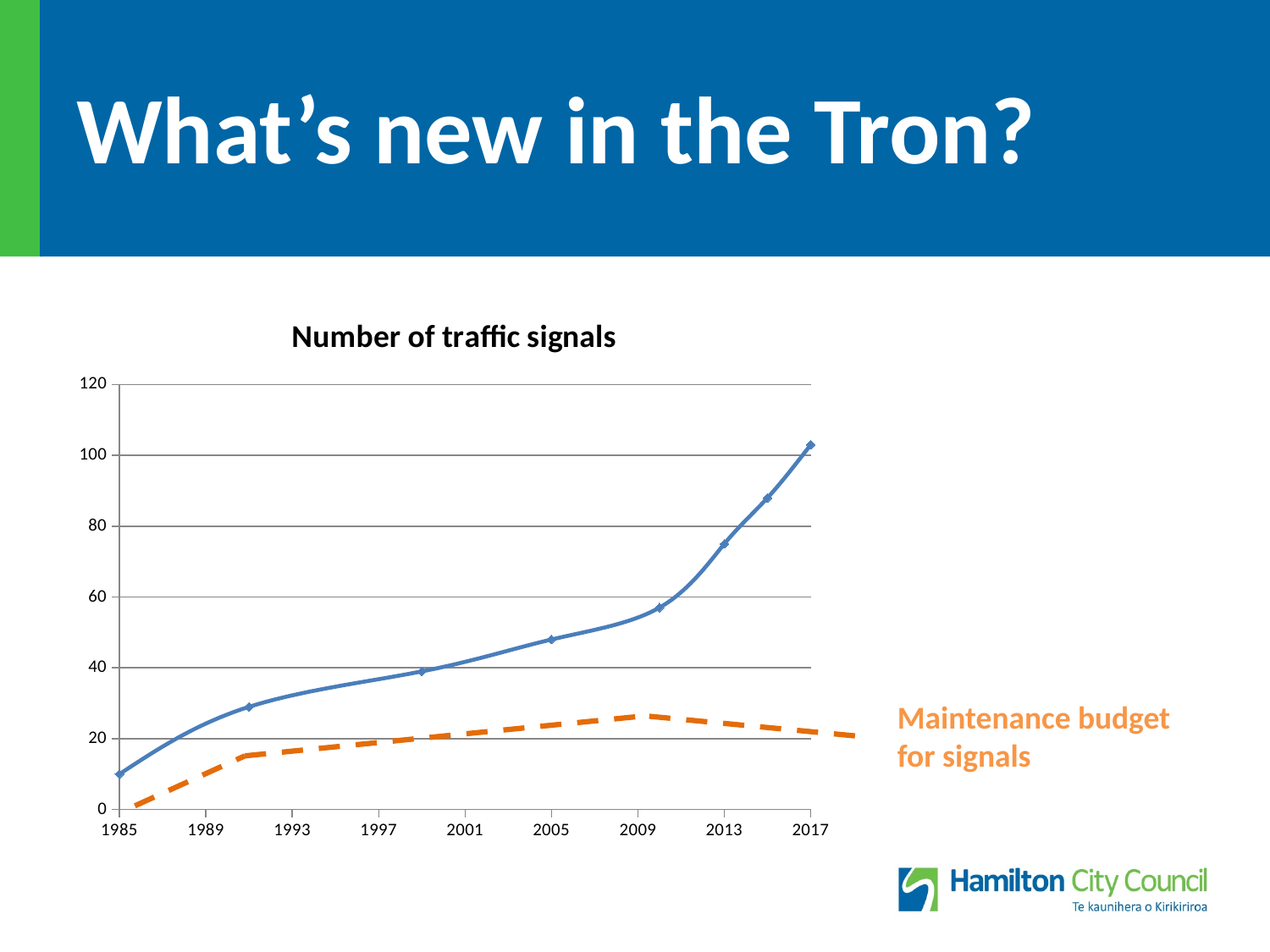
Is the number of traffic signals in 2017 greater or less than 80? greater Is the number of traffic signals in 2005 greater or less than 40? greater How many year labels are shown on the x axis? 9 Is the number of traffic signals in 2013 greater or less than 60? greater Does the maintenance budget for signals line rise or fall between 2009 and 2017? fall What is the title of the chart? Number of traffic signals What kind of chart is shown on the slide? line chart Does the number of traffic signals rise or fall from 1985 to 2017? rise In 2017, which line is higher: the number of traffic signals or the maintenance budget for signals? Number of traffic signals What does the orange dashed line on the chart represent? Maintenance budget for signals